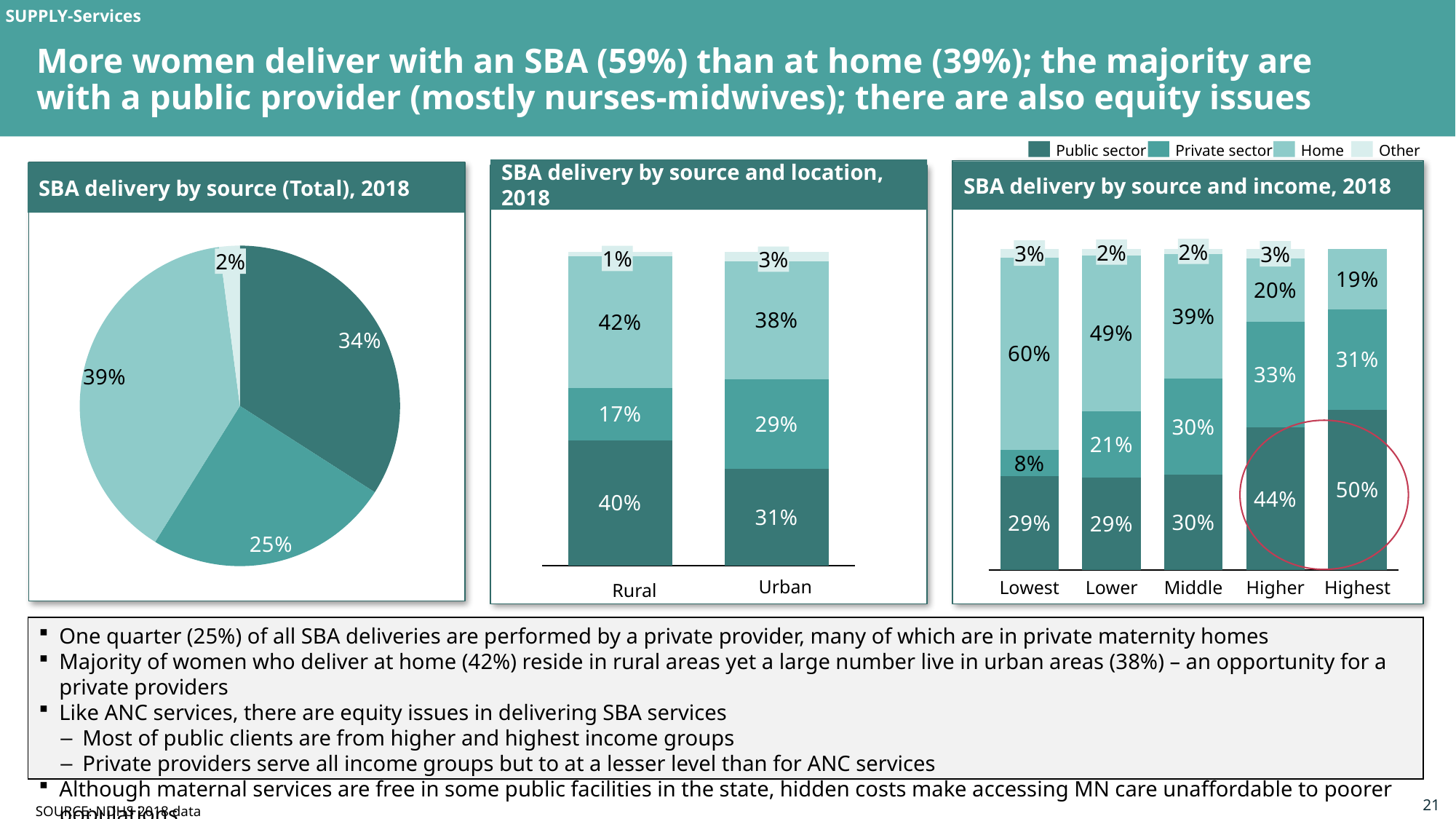
In the 'SBA delivery by source and location, 2018' chart, what is the difference between the Private sector values for Urban and Rural? 12% In the 'SBA delivery by source (Total), 2018' pie chart, what share is Home? 39% How many series does the legend list for the stacked bar charts? 4 In the 'SBA delivery by source and income, 2018' chart, does the Public sector value rise or fall from Lowest to Highest income? Rise In the 'SBA delivery by source (Total), 2018' pie chart, which source has the smallest share? Other In the 'SBA delivery by source and income, 2018' chart, how many income groups are shown on the x axis? 5 In the 'SBA delivery by source and income, 2018' chart, which income group has the highest Home value? Lowest In the 'SBA delivery by source and income, 2018' chart, what is the difference between the Private sector values for Middle and Lowest? 22% In the 'SBA delivery by source and location, 2018' chart, which location has the larger Home value, Rural or Urban? Rural In the 'SBA delivery by source and location, 2018' chart, what is the Public sector value for Rural? 40% In the 'SBA delivery by source and income, 2018' chart, what is the Public sector value for the Highest income group? 50% What kind of chart is 'SBA delivery by source (Total), 2018'? Pie chart